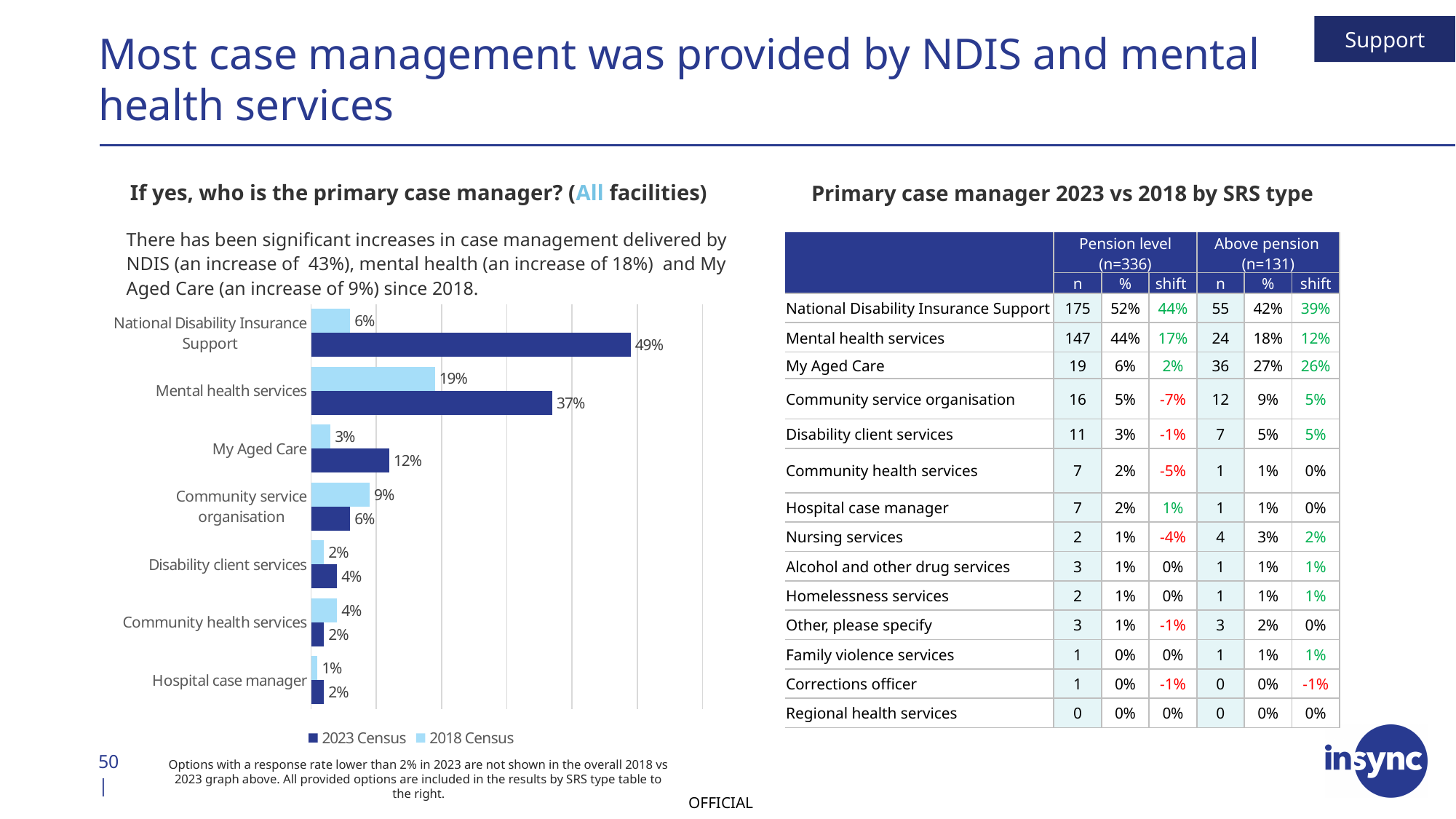
Which is larger for Community health services, the 2023 Census value or the 2018 Census value? 2018 Census What is the 2023 Census value for My Aged Care? 12% How many series does the chart legend list? 2 What is the 2023 Census value for National Disability Insurance Support? 49% Which category has the highest 2023 Census value? National Disability Insurance Support How many categories are shown in the bar chart? 7 Which category has the lowest 2018 Census value? Hospital case manager What is the difference between the 2023 Census and 2018 Census values for National Disability Insurance Support? 43% What kind of chart is shown on the slide? Bar chart What is the 2018 Census value for Mental health services? 19% What is the 2018 Census value for Community service organisation? 9% Which series is shown in light blue in the chart legend? 2018 Census